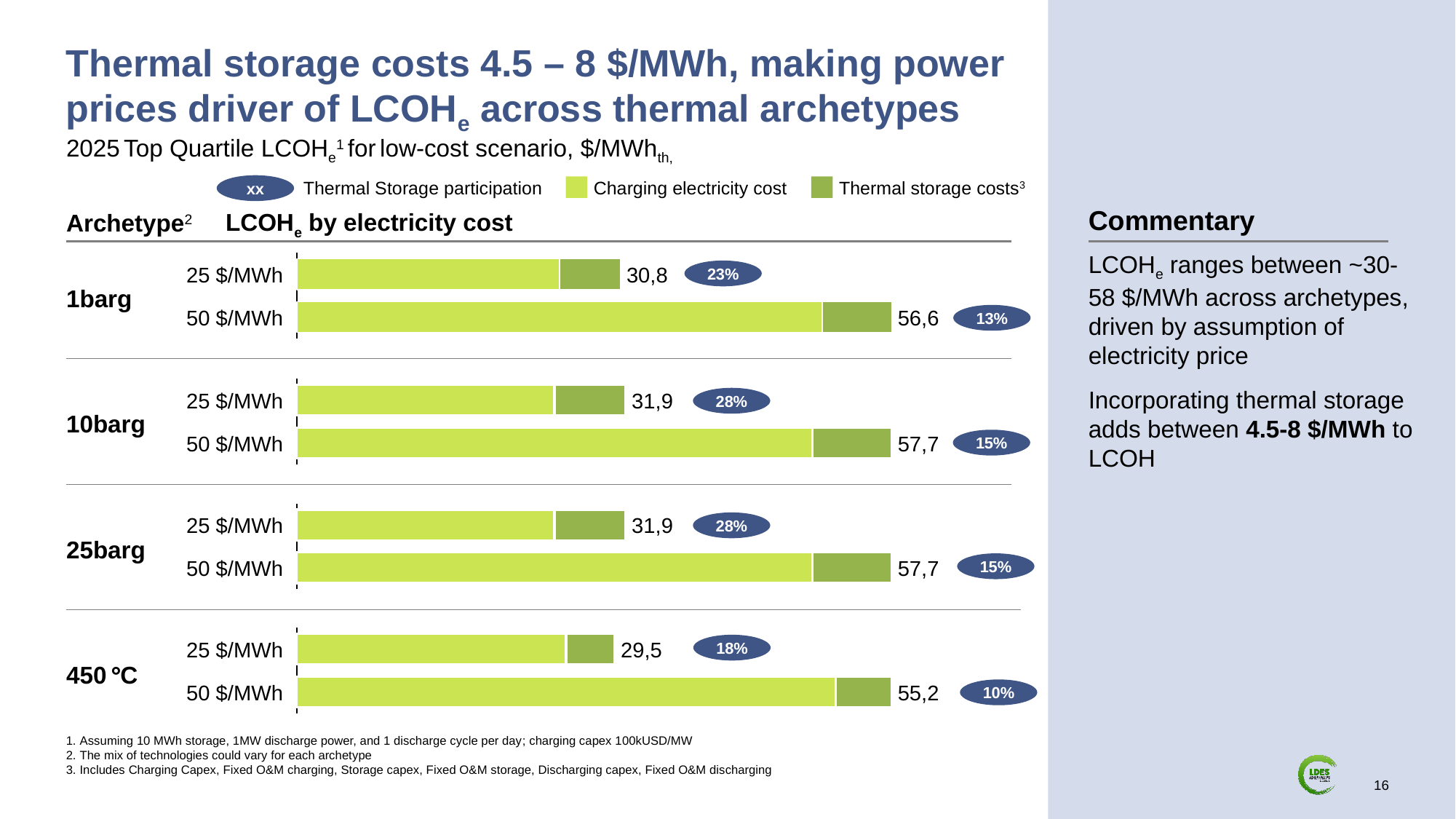
What type of chart is used on this slide? Stacked bar chart What is the difference between the 50 $/MWh total LCOHe for 10barg and for 450 °C? 2,5 What is the total LCOHe for the 1barg archetype at 25 $/MWh electricity cost? 30,8 How many archetypes are shown on the chart? 4 What thermal storage participation percentage is shown for the 10barg archetype at 25 $/MWh? 28% What is the total LCOHe for the 450 °C archetype at 50 $/MWh electricity cost? 55,2 Which bar has the highest total LCOHe value on the chart? 10barg and 25barg at 50 $/MWh (57,7) What thermal storage participation percentage is shown for the 450 °C archetype at 50 $/MWh? 10% What is the difference between the 50 $/MWh and 25 $/MWh total LCOHe values for the 1barg archetype? 25,8 How many stacked series does the legend list for the bars? 2 Which is larger: the 25 $/MWh total LCOHe for 1barg or for 10barg? 10barg Which bar has the lowest total LCOHe value on the chart? 450 °C at 25 $/MWh (29,5)